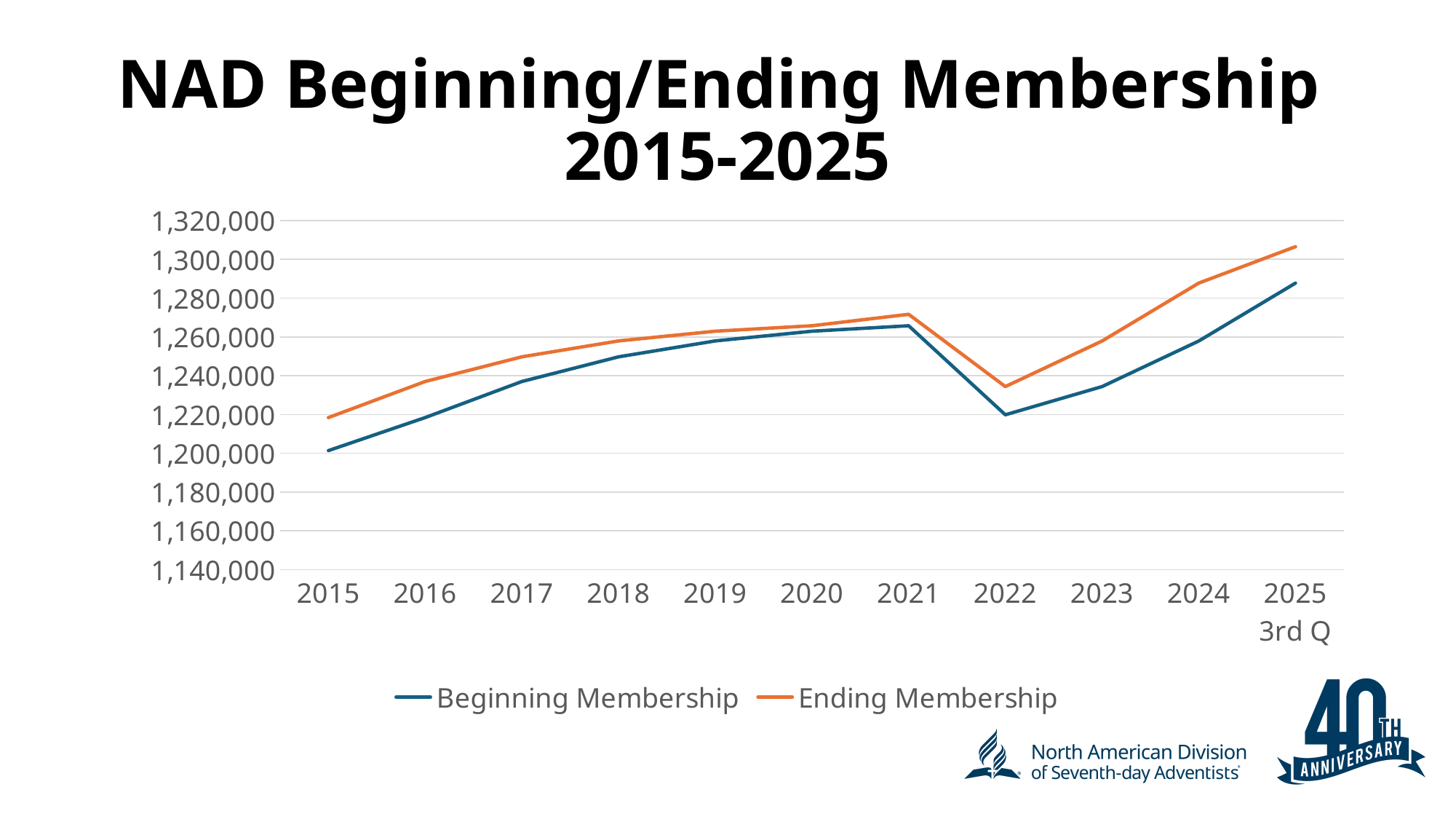
How many series does the legend list? 2 In 2022, which is larger: Beginning Membership or Ending Membership? Ending Membership Is the Beginning Membership value for 2021 greater or less than 1,260,000? greater In which year does the Ending Membership line reach its highest value? 2025 3rd Q How many points are plotted along the x axis for each series? 11 Do the membership values rise or fall from 2021 to 2022? fall In which year is the Beginning Membership at its lowest? 2015 Is the Ending Membership value for 2025 3rd Q greater or less than 1,300,000? greater Is the Ending Membership value for 2022 greater or less than 1,240,000? less What kind of chart is shown on the slide? line chart In which year is the Ending Membership at its lowest? 2015